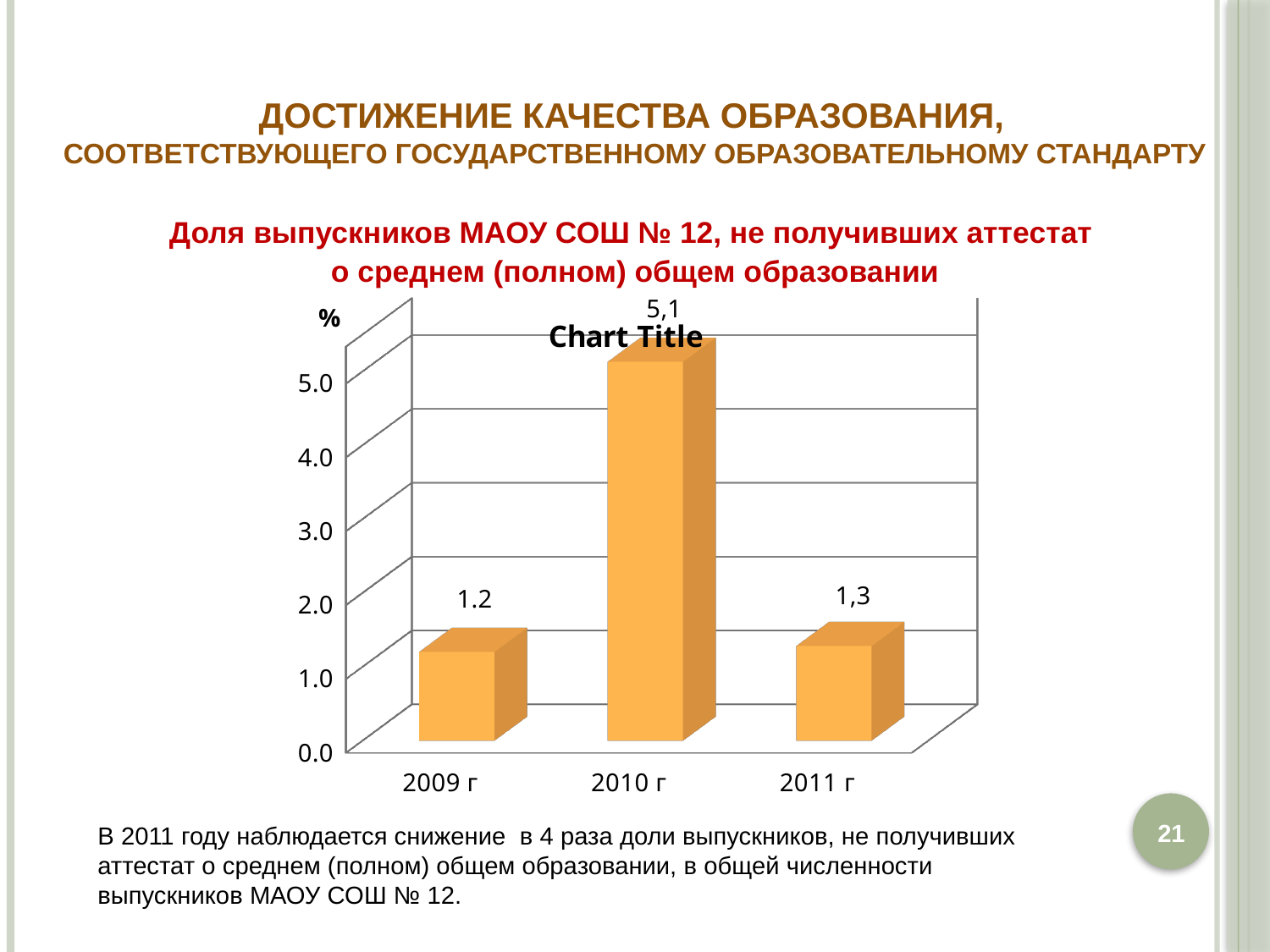
What is the value for 2010 г? 5,1 What is the value for 2011 г? 1,3 What kind of chart is shown on the slide? bar chart Which year has the highest value? 2010 г What unit label is shown at the top of the vertical axis? % How many years are shown on the x axis? 3 What is the difference between the values for 2010 г and 2011 г? 3,8 Which is larger, the value for 2009 г or the value for 2010 г? 2010 г Is the value for 2011 г greater or less than 2.0? less What is the value for 2009 г? 1.2 Is the value for 2010 г greater or less than 4.0? greater Which year has the lowest value? 2009 г